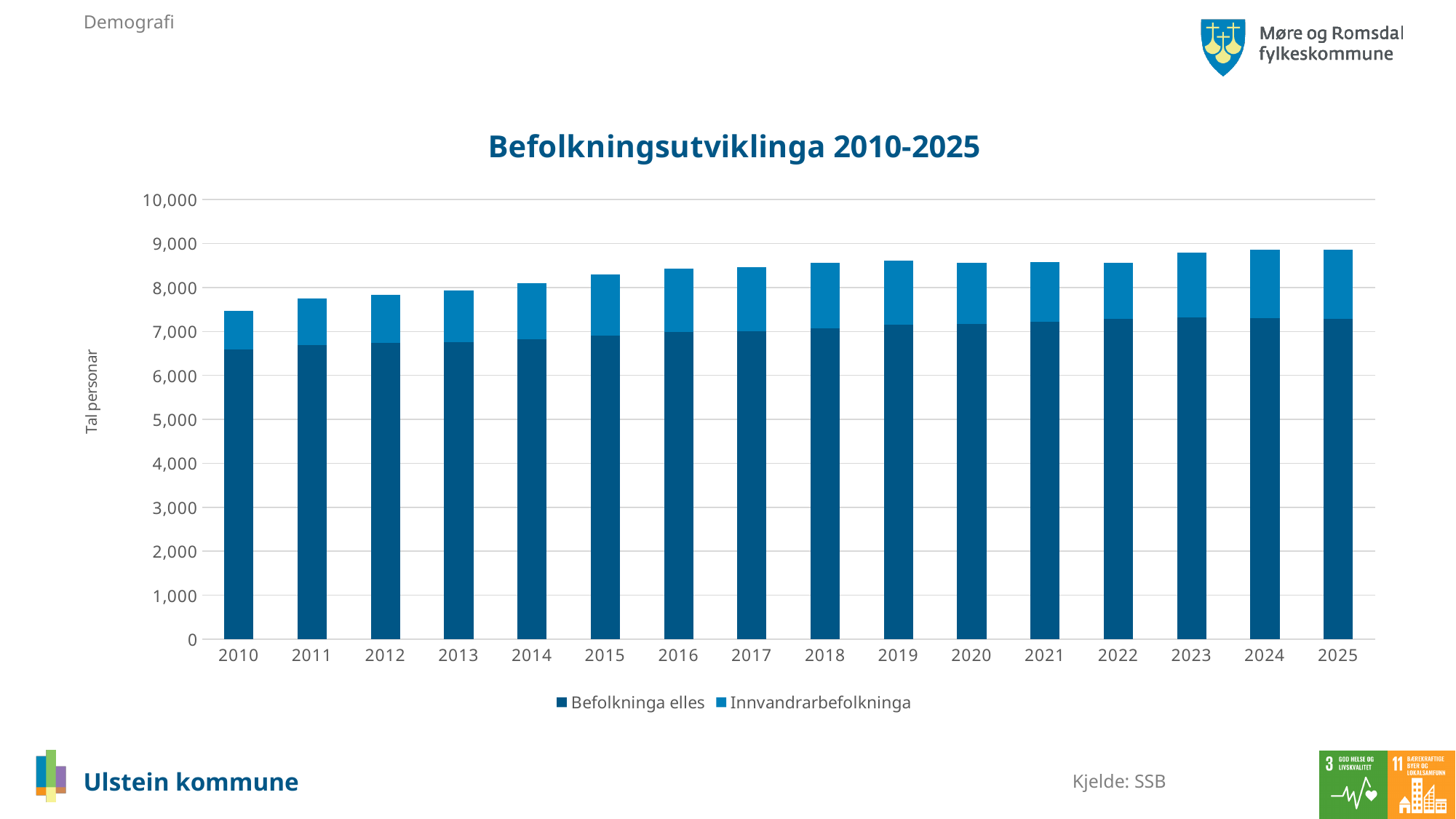
Does the total population rise or fall overall from 2010 to 2025? rise Is the total bar for 2025 greater or less than 8,000? greater Is the total bar for 2010 greater or less than 8,000? less How many series does the chart's legend list? 2 Is the total bar for 2016 greater or less than 8,000? greater What is the label on the y axis of the chart? Tal personar Which year has the lowest total bar in the chart? 2010 What kind of chart is shown on the slide? Stacked bar chart What is the title of the chart? Befolkningsutviklinga 2010-2025 How many years are shown on the x axis of the chart? 16